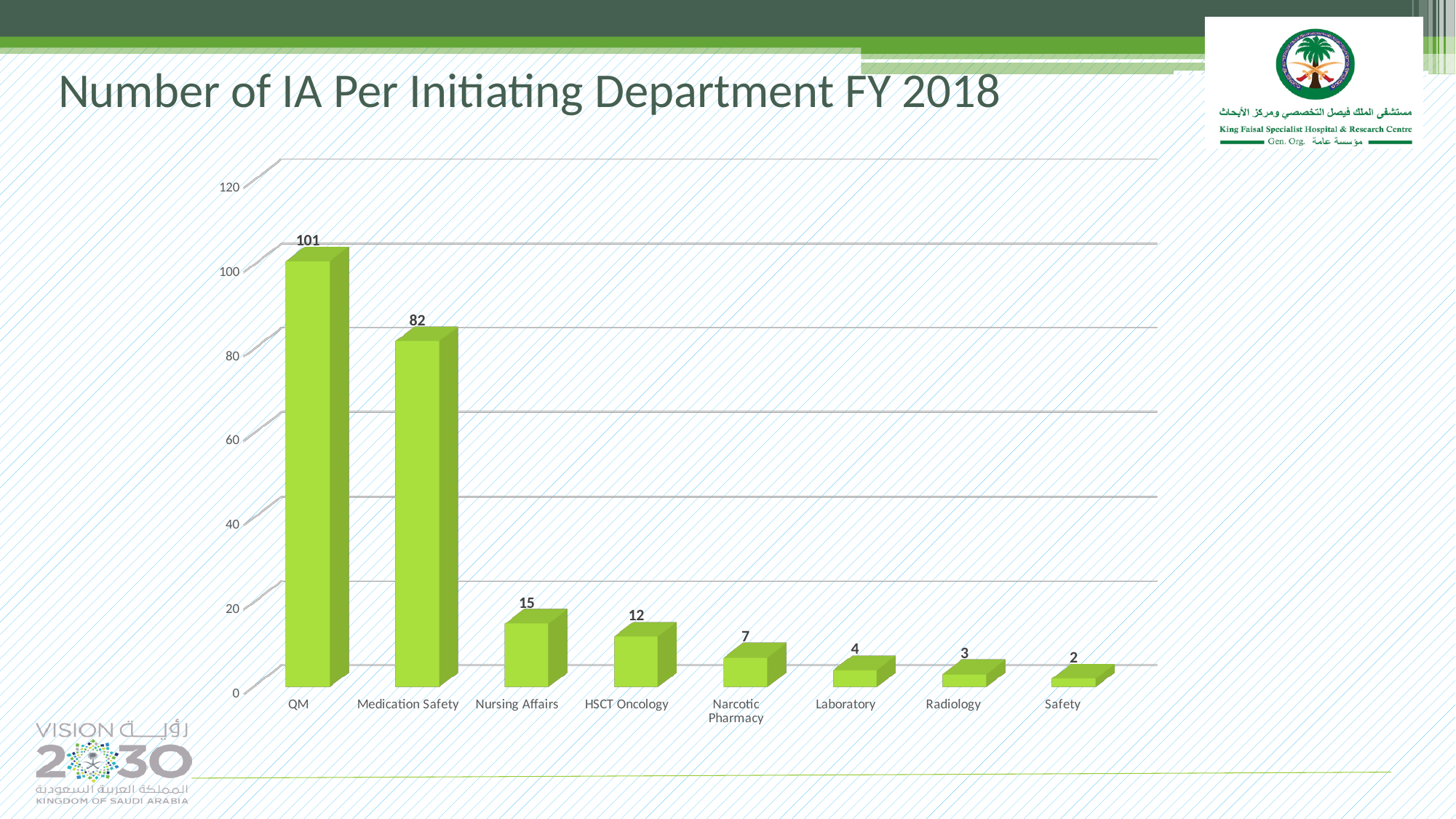
Do the values rise or fall from left to right across the departments? Fall Which has more IA, Nursing Affairs or HSCT Oncology? Nursing Affairs What kind of chart is shown on the slide? Bar chart What is the number of IA for Medication Safety? 82 Which department has the highest number of IA? QM What is the number of IA for Narcotic Pharmacy? 7 What is the title of the chart? Number of IA Per Initiating Department FY 2018 What is the number of IA for QM? 101 Which department has the lowest number of IA? Safety How many departments are shown on the chart? 8 What is the difference between the number of IA for QM and Medication Safety? 19 What is the number of IA for Radiology? 3